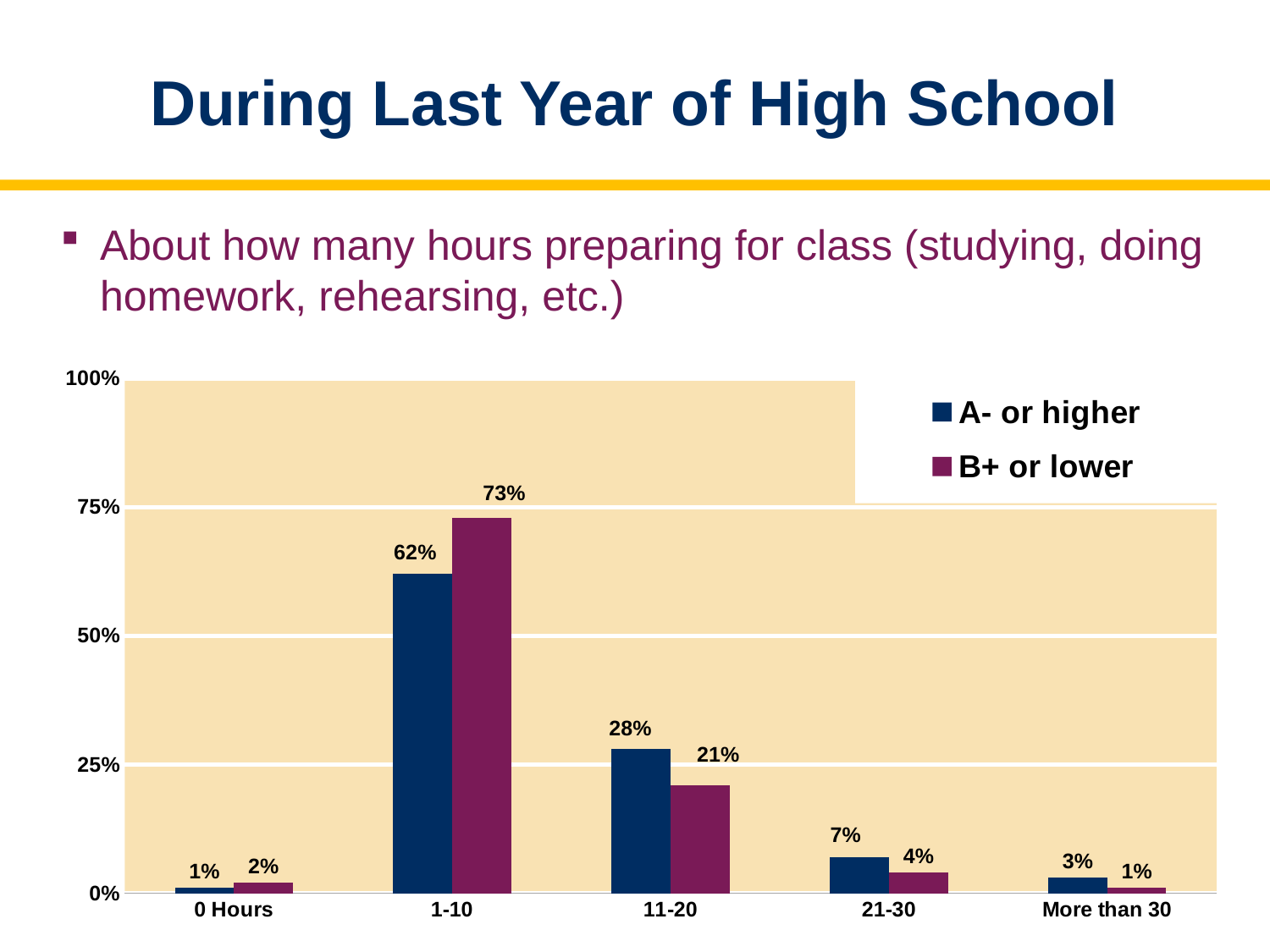
What percentage of the "A- or higher" group spent 1-10 hours preparing for class? 62% What percentage of the "B+ or lower" group spent 11-20 hours preparing for class? 21% Which hours category has the highest value for the "B+ or lower" series? 1-10 What kind of chart is shown on the slide? Bar chart Which hours category has the lowest value for the "A- or higher" series? 0 Hours In the 21-30 hours category, which series has the larger value? A- or higher How many hours categories are shown on the x axis? 5 How many series does the legend list? 2 What are the two series named in the legend? A- or higher; B+ or lower What is the difference between the "B+ or lower" and "A- or higher" values in the 1-10 hours category? 11% Is the value for "A- or higher" in the 11-20 category greater or less than 25%? greater What is the value for "B+ or lower" in the "More than 30" category? 1%